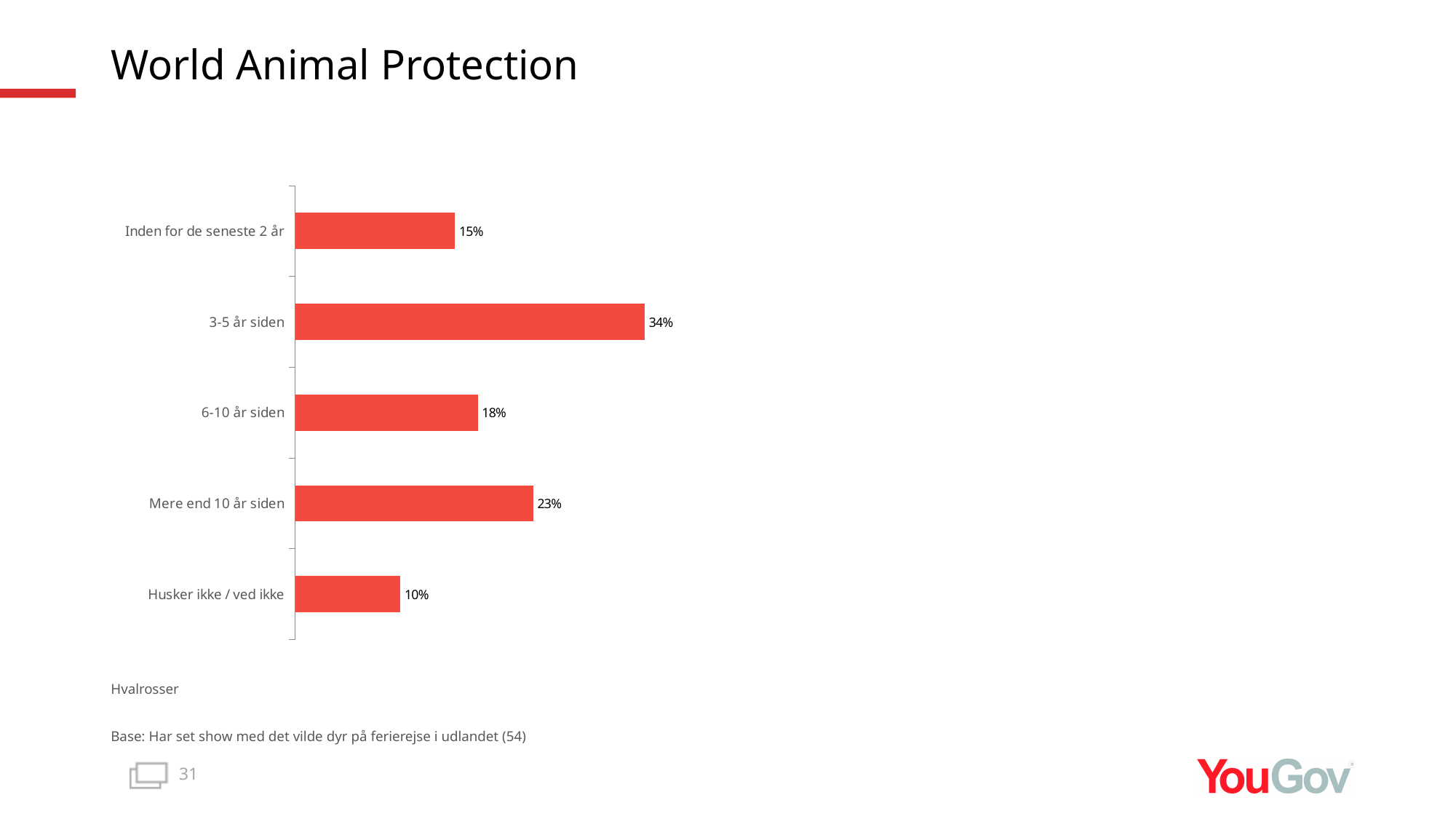
What is the value for "Mere end 10 år siden"? 23% What is the difference between the values for "Mere end 10 år siden" and "Inden for de seneste 2 år"? 8% Which category has the lowest value? Husker ikke / ved ikke What is the value for "Husker ikke / ved ikke"? 10% What is the base size stated below the chart? 54 How many categories are shown in the chart? 5 What is the value for "3-5 år siden"? 34% Which category has the highest value? 3-5 år siden Which is larger, the value for "6-10 år siden" or the value for "Mere end 10 år siden"? Mere end 10 år siden What is the difference between the values for "3-5 år siden" and "6-10 år siden"? 16% What is the value for "Inden for de seneste 2 år"? 15% What kind of chart is shown on the slide? Bar chart